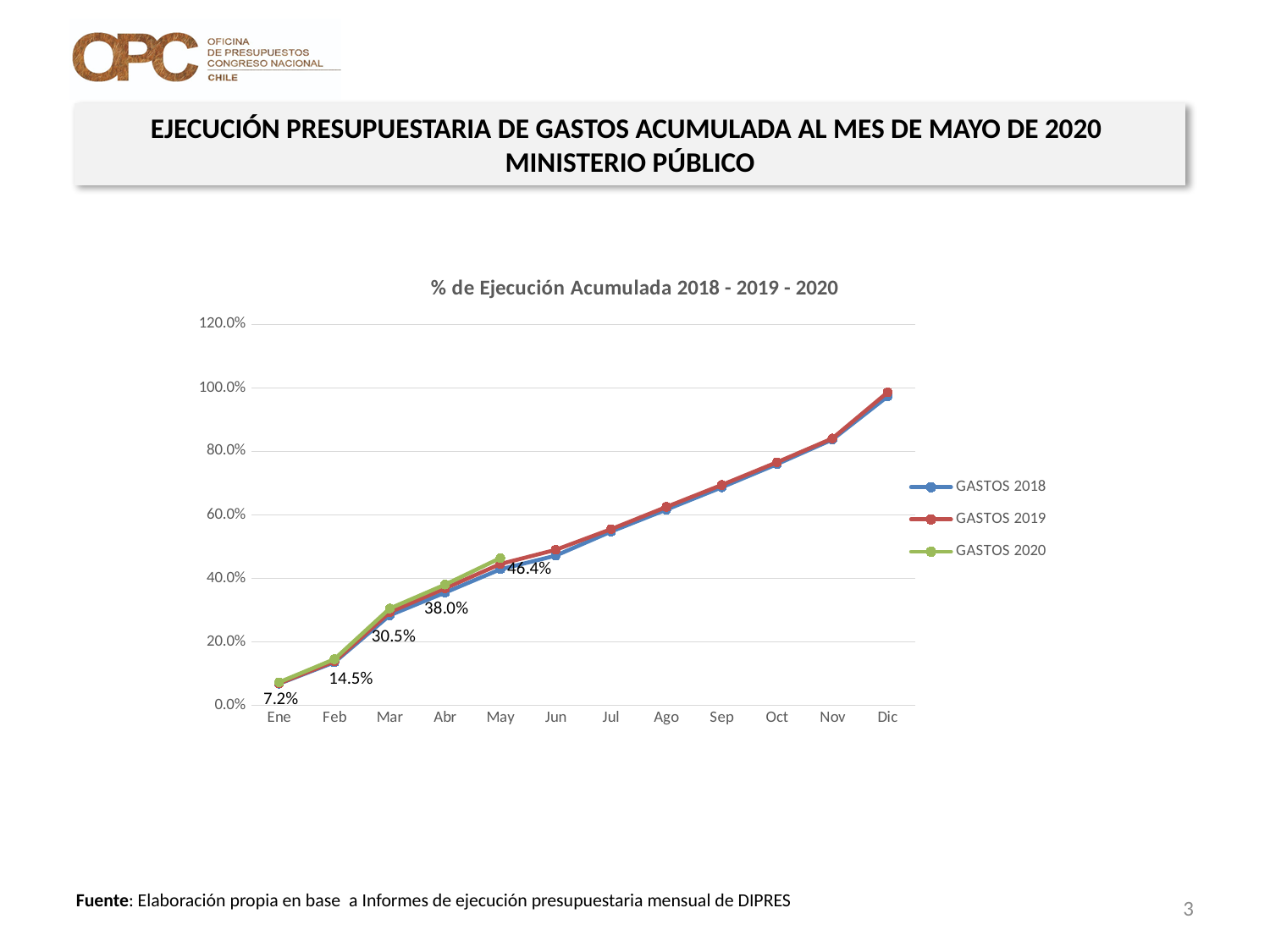
Is the value for GASTOS 2019 in Dic greater or less than 80.0%? greater What is the value for GASTOS 2020 in Abr? 38.0% How many months are shown on the x axis? 12 What is the difference between the GASTOS 2020 values for Mar and Feb? 16.0% What kind of chart is shown on the slide? Line chart Do the GASTOS 2018 values rise or fall from Ene to Dic? rise What is the value for GASTOS 2020 in Mar? 30.5% What is the value for GASTOS 2020 in Ene? 7.2% How many series does the legend list? 3 What is the difference between the GASTOS 2020 values for May and Abr? 8.4% In which month does GASTOS 2020 reach its highest labelled value? May What is the value for GASTOS 2020 in May? 46.4%